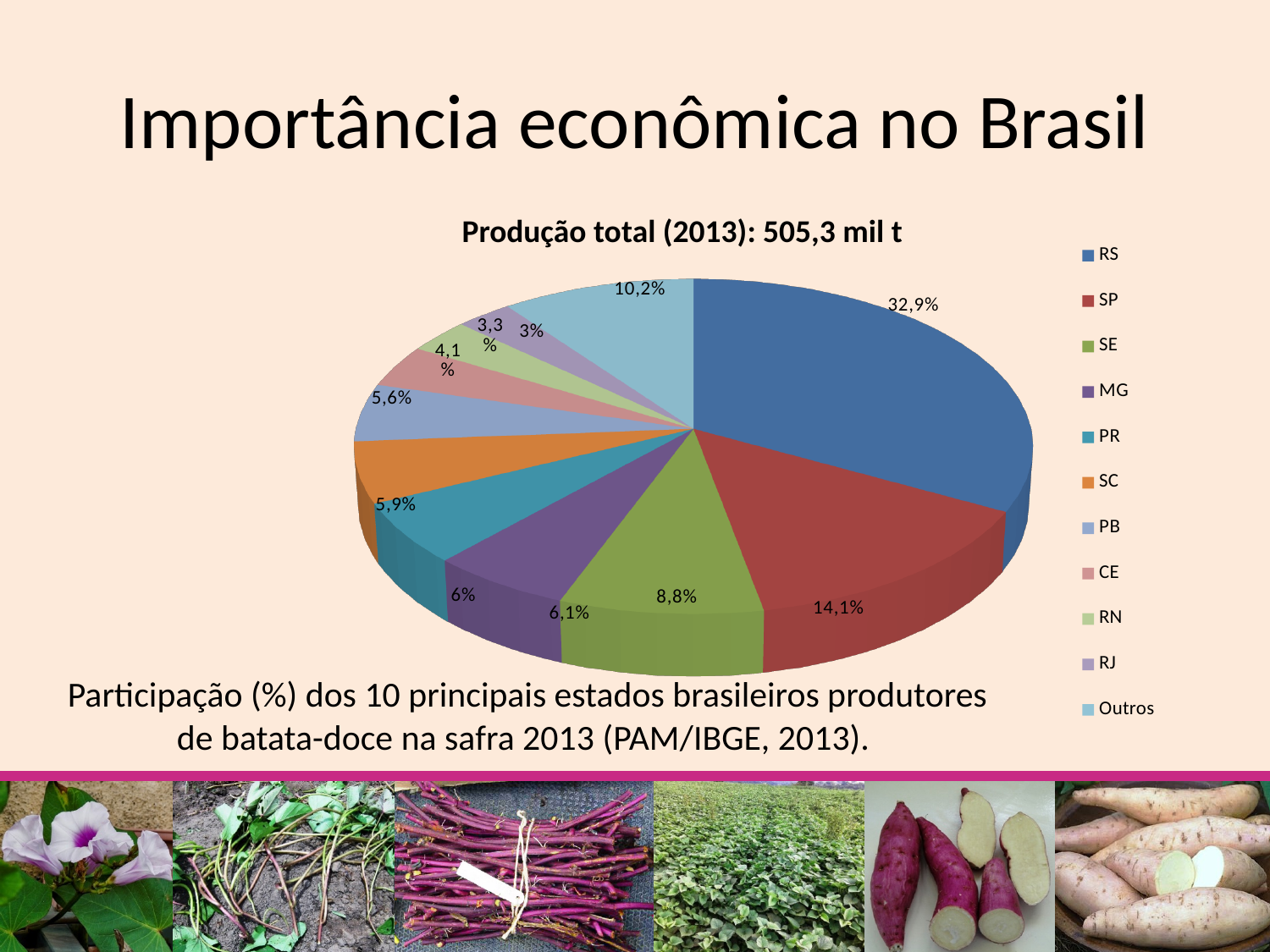
What is the difference between the shares of RS and SP? 18,8% What share of the pie does SP have? 14,1% What share of the pie does RS have? 32,9% What is the title of the chart? Produção total (2013): 505,3 mil t Which has a larger share, SE or CE? SE What share of the pie does SE have? 8,8% What share of the pie does Outros have? 10,2% What kind of chart is shown on the slide? pie chart How many entries does the chart legend list? 11 Which state has the largest slice of the pie? RS Which legend entry has the smallest slice of the pie? RJ What share of the pie does RJ have? 3%